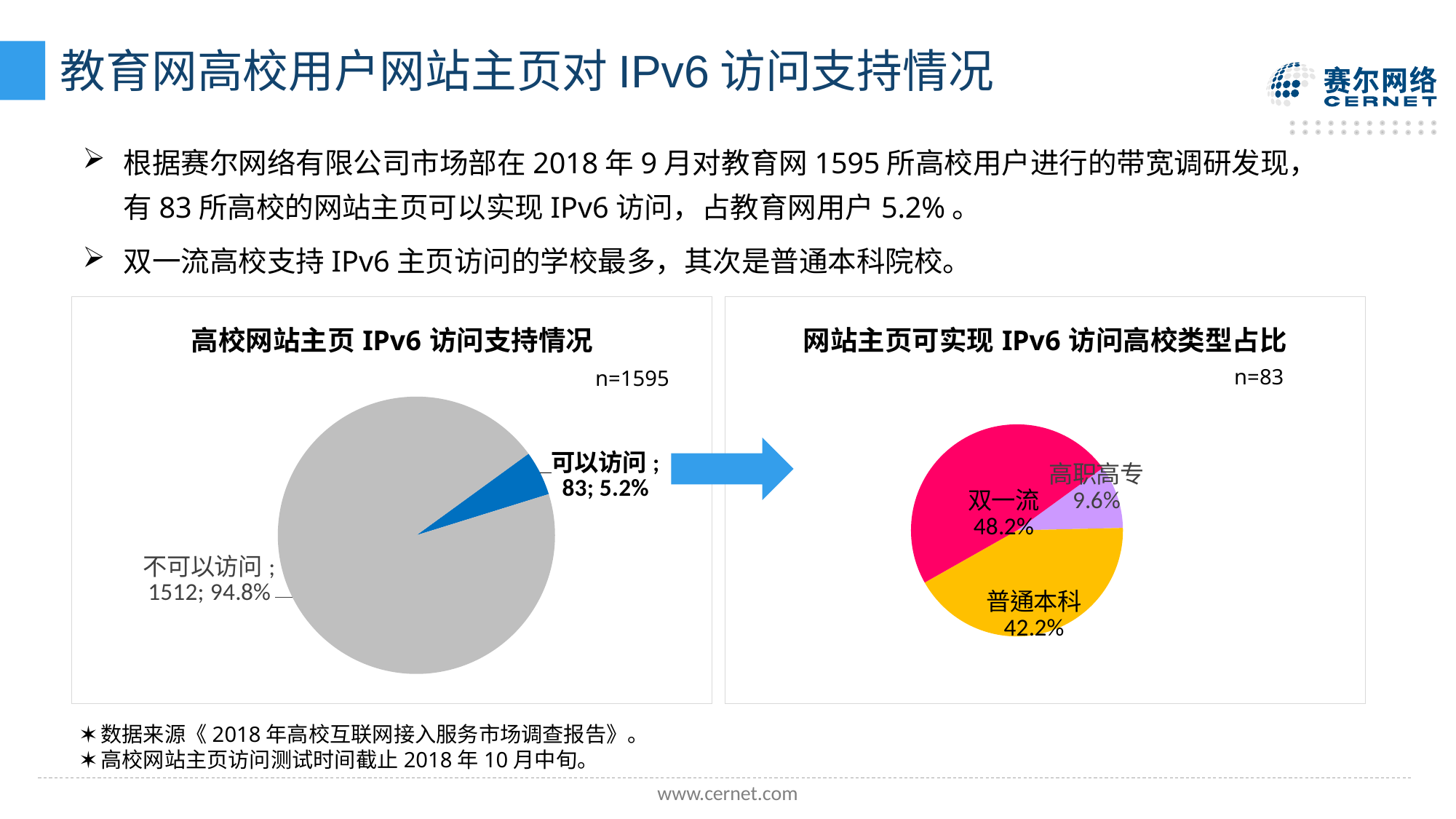
In the right chart titled 网站主页可实现 IPv6 访问高校类型占比, what is the difference between the shares of 普通本科 and 高职高专? 32.6% In the left chart titled 高校网站主页 IPv6 访问支持情况, what is the value for 可以访问? 83; 5.2% In the right chart titled 网站主页可实现 IPv6 访问高校类型占比, which category has the smallest share? 高职高专 In the left chart titled 高校网站主页 IPv6 访问支持情况, which category has the largest slice? 不可以访问 In the right chart titled 网站主页可实现 IPv6 访问高校类型占比, what share does 高职高专 have? 9.6% In the left chart titled 高校网站主页 IPv6 访问支持情况, what kind of chart is shown? pie chart In the left chart titled 高校网站主页 IPv6 访问支持情况, how many slices does the pie have? 2 In the left chart titled 高校网站主页 IPv6 访问支持情况, what is the sample size n shown? n=1595 In the left chart titled 高校网站主页 IPv6 访问支持情况, what is the value for 不可以访问? 1512; 94.8% In the left chart titled 高校网站主页 IPv6 访问支持情况, what is the difference in count between 不可以访问 and 可以访问? 1429 In the right chart titled 网站主页可实现 IPv6 访问高校类型占比, what share does 双一流 have? 48.2% In the right chart titled 网站主页可实现 IPv6 访问高校类型占比, which is larger, 双一流 or 普通本科? 双一流